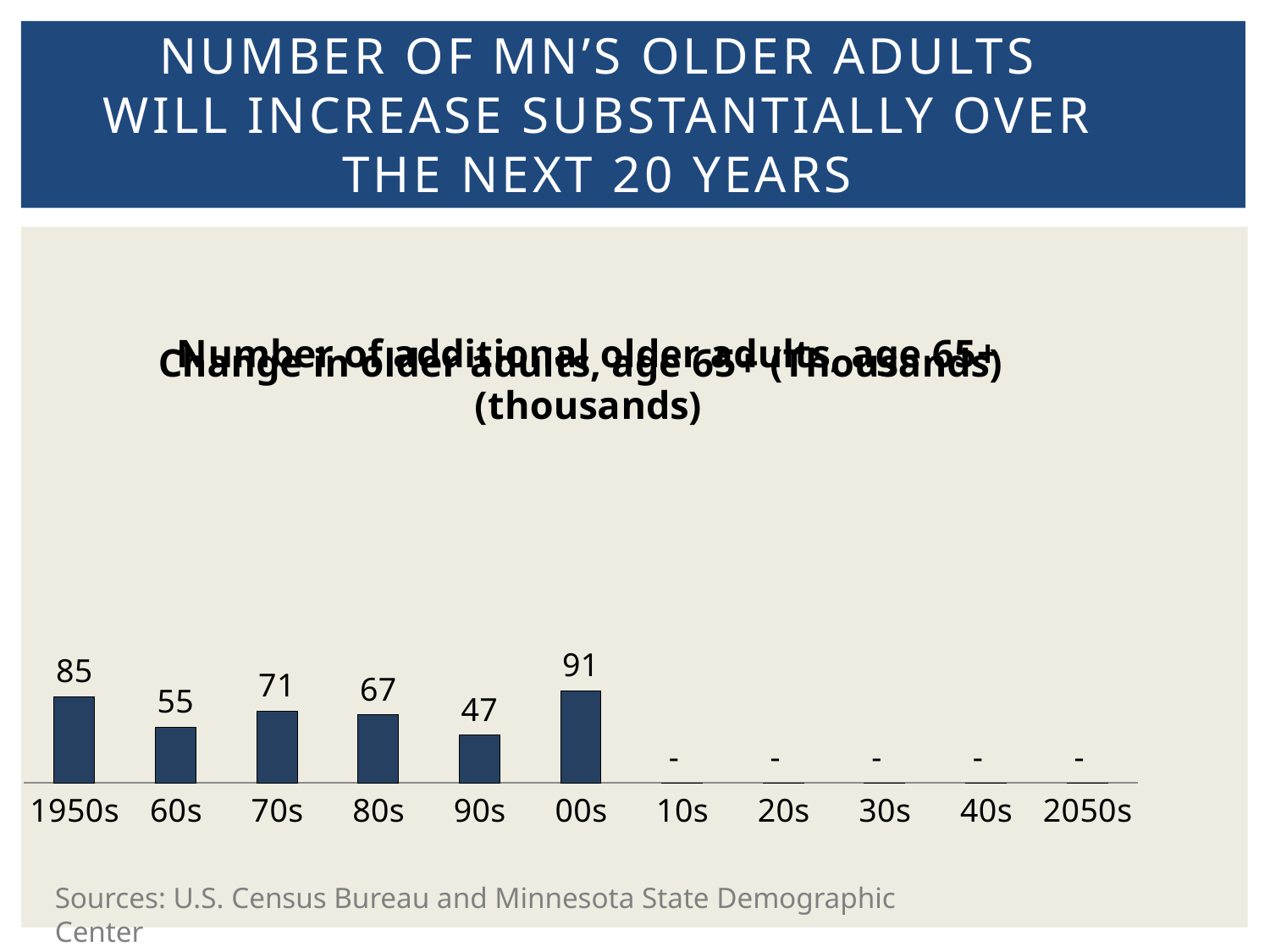
Does the value rise or fall from the 1950s to the 60s? Fall Among the decades with a plotted bar, which has the lowest value? 90s Which decade has the highest value? 00s What is the value for the 90s? 47 What is the value for the 70s? 71 What is the value for the 1950s? 85 What is the difference between the values for the 1950s and the 60s? 30 What is the difference between the values for the 00s and the 90s? 44 Which is larger, the value for the 70s or the value for the 80s? 70s What is the value for the 00s? 91 How many decade categories are shown on the x axis? 11 What kind of chart is shown on the slide? Bar chart